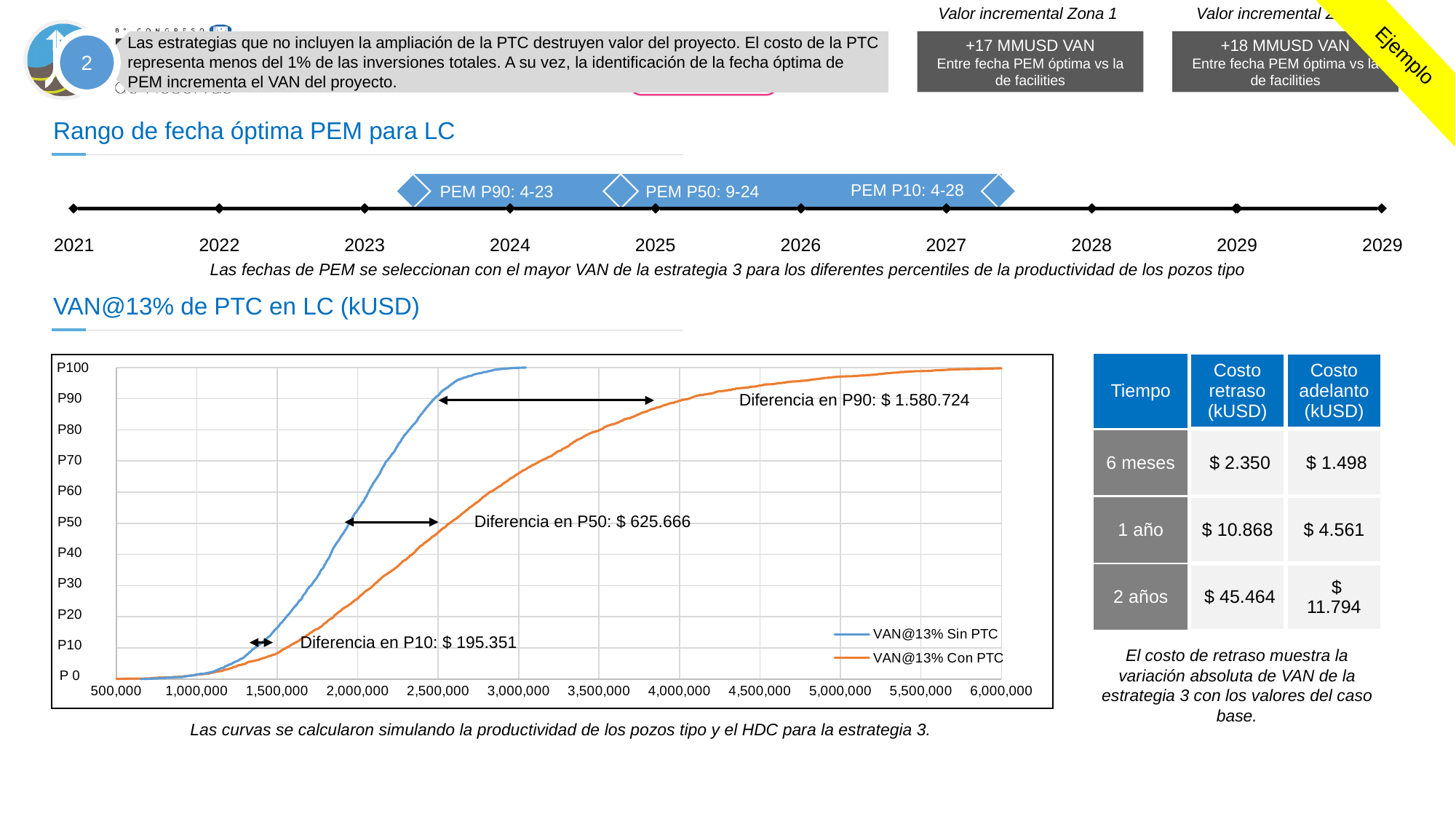
In the VAN@13% chart, what is the value labelled 'Diferencia en P90'? $ 1.580.724 In the VAN@13% chart, what is the value labelled 'Diferencia en P50'? $ 625.666 In the VAN@13% chart, is the VAN value at which the 'VAN@13% Con PTC' curve reaches P90 greater or less than 3,500,000? greater How many series does the legend of the VAN@13% chart list? 2 In the VAN@13% chart, at which percentile (P10, P50 or P90) is the labelled difference between the two curves largest? P90 In the VAN@13% chart, is the VAN value at which the 'VAN@13% Sin PTC' curve reaches P50 greater or less than 2,500,000? less In the VAN@13% chart, which series reaches P100 at a higher VAN value, 'VAN@13% Sin PTC' or 'VAN@13% Con PTC'? VAN@13% Con PTC In the VAN@13% chart, at which percentile (P10, P50 or P90) is the labelled difference between the two curves smallest? P10 In the VAN@13% chart, what is the value labelled 'Diferencia en P10'? $ 195.351 In the VAN@13% chart, which colour is used for the 'VAN@13% Con PTC' series? orange In the VAN@13% chart, how much larger is the labelled difference at P90 than the labelled difference at P50? $ 955.058 What kind of chart is shown under the title 'VAN@13% de PTC en LC (kUSD)'? line chart